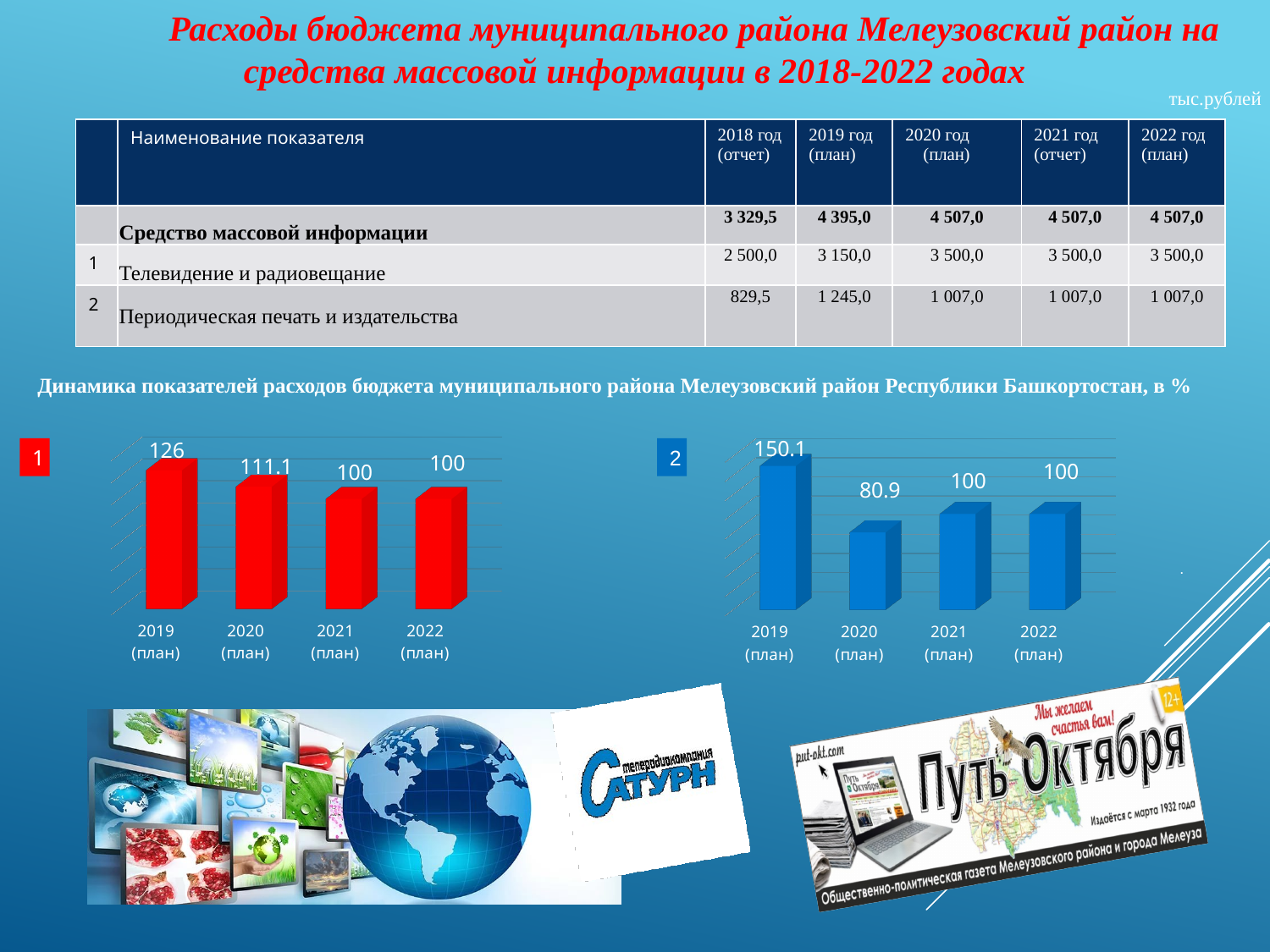
In the right chart (labeled 2), which year has the lowest value? 2020 (план) What kind of chart is the right chart (labeled 2)? bar chart In the right chart (labeled 2), which is larger: the value for 2020 (план) or the value for 2021 (план)? 2021 (план) In the right chart (labeled 2), what is the difference between the values for 2019 (план) and 2020 (план)? 69.2 In the right chart (labeled 2), what is the value for 2020 (план)? 80.9 In the right chart (labeled 2), what is the value for 2019 (план)? 150.1 In the left chart (labeled 1), what is the value for 2020 (план)? 111.1 In the left chart (labeled 1), what is the value for 2019 (план)? 126 In the left chart (labeled 1), which year has the highest value? 2019 (план) How many bars are shown in the left chart (labeled 1)? 4 In the left chart (labeled 1), what is the difference between the values for 2019 (план) and 2020 (план)? 14.9 What colour are the bars in the left chart (labeled 1)? red